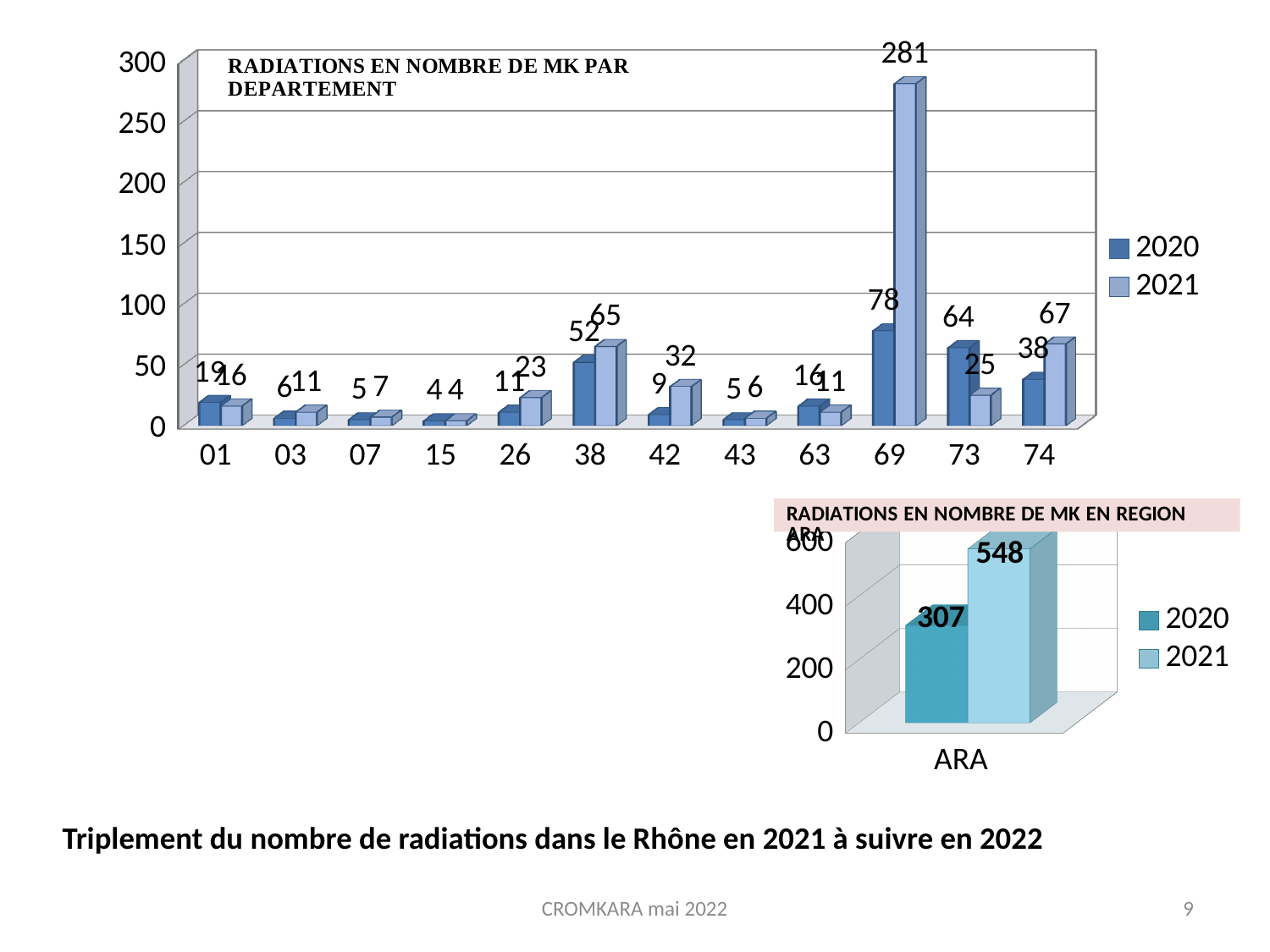
What kind of chart is 'RADIATIONS EN NOMBRE DE MK PAR DEPARTEMENT'? Bar chart In the chart 'RADIATIONS EN NOMBRE DE MK PAR DEPARTEMENT', what is the difference between the 2021 and 2020 values for department 69? 203 In the chart 'RADIATIONS EN NOMBRE DE MK EN REGION ARA', what is the value for 2021? 548 In the chart 'RADIATIONS EN NOMBRE DE MK EN REGION ARA', is the 2020 value greater or less than 400? less In the chart 'RADIATIONS EN NOMBRE DE MK PAR DEPARTEMENT', which is larger for department 73: the 2020 value or the 2021 value? 2020 In the chart 'RADIATIONS EN NOMBRE DE MK PAR DEPARTEMENT', how many series does the legend list? 2 In the chart 'RADIATIONS EN NOMBRE DE MK PAR DEPARTEMENT', what is the 2021 value for department 69? 281 In the chart 'RADIATIONS EN NOMBRE DE MK PAR DEPARTEMENT', how many departments are shown on the x axis? 12 In the chart 'RADIATIONS EN NOMBRE DE MK PAR DEPARTEMENT', what is the 2020 value for department 38? 52 In the chart 'RADIATIONS EN NOMBRE DE MK PAR DEPARTEMENT', which department has the highest 2021 value? 69 In the chart 'RADIATIONS EN NOMBRE DE MK PAR DEPARTEMENT', which department has the lowest 2020 value? 15 In the chart 'RADIATIONS EN NOMBRE DE MK EN REGION ARA', what is the difference between the 2021 and 2020 values? 241